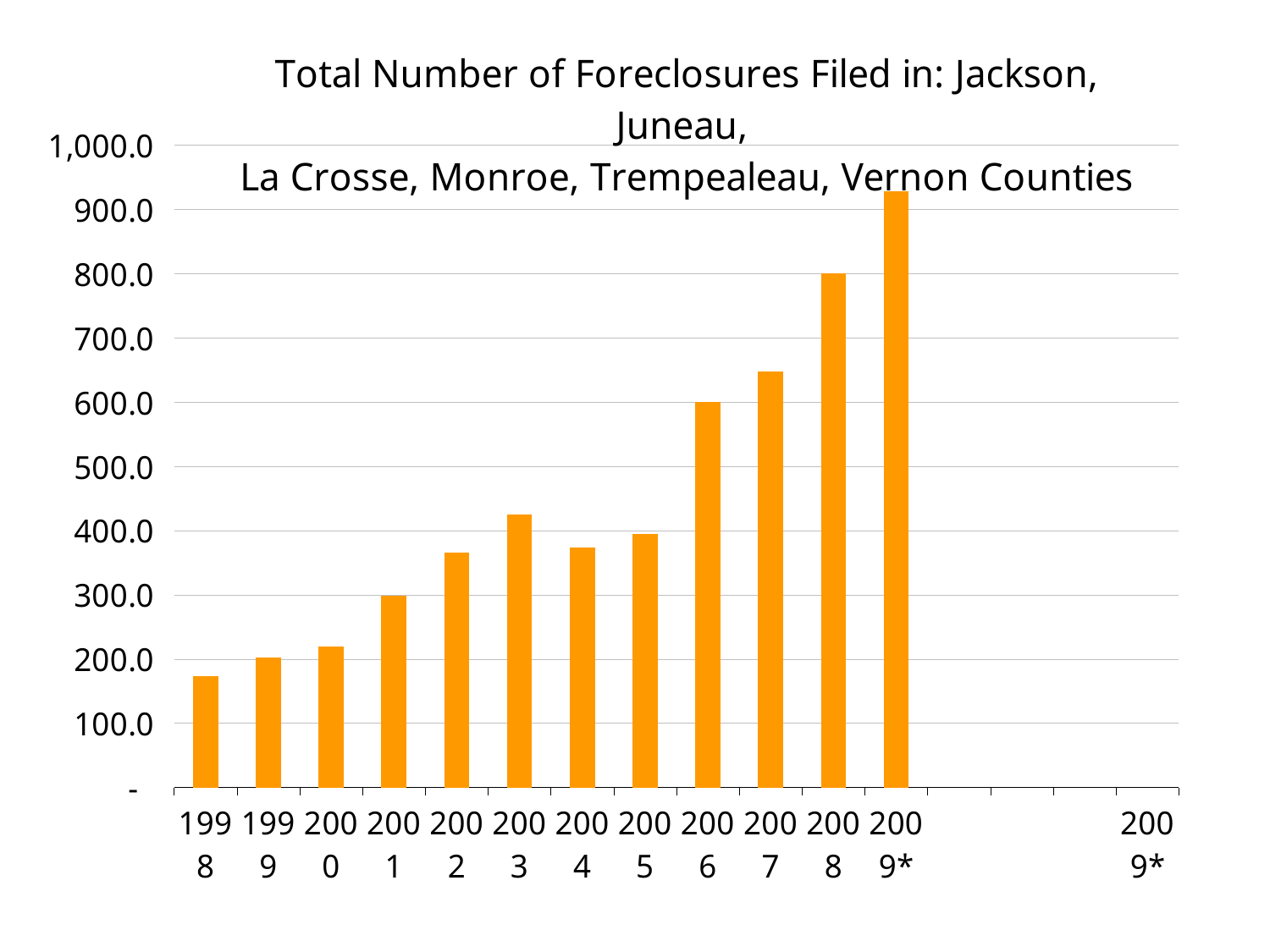
What colour are the bars in the chart? orange Is the value for 2006 greater or less than 500? greater Which year has more foreclosures filed, 2003 or 2004? 2003 Is the value for 2004 greater or less than 400? less Which year has the lowest number of foreclosures filed? 1998 Which year has the highest number of foreclosures filed? 2009* Do the number of foreclosures generally rise or fall from 1998 to 2009*? rise Is the value for 1998 greater or less than 200? less How many bars are plotted in the chart? 12 What kind of chart is shown on the slide? bar chart Which year has more foreclosures filed, 2007 or 2008? 2008